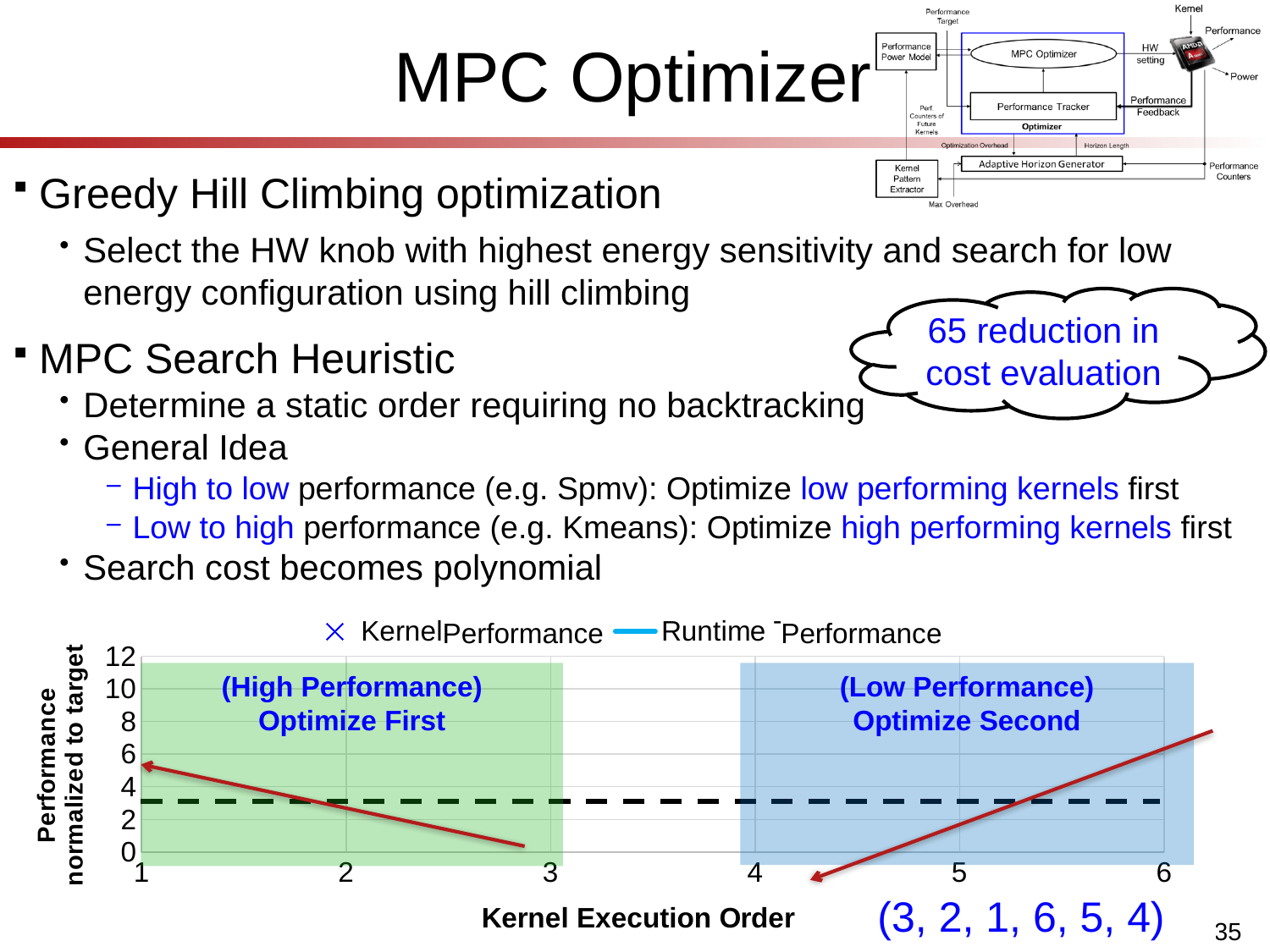
How many series does the legend of the chart list? 2 Is the dashed horizontal line in the chart at a value greater or less than 2 on the y axis? greater What is the title of the x axis of the chart? Kernel Execution Order What are the two series named in the chart legend? Kernel Performance and Runtime Performance Is the dashed horizontal line in the chart at a value greater or less than 6 on the y axis? less How many kernel execution order positions are marked on the x axis of the chart? 6